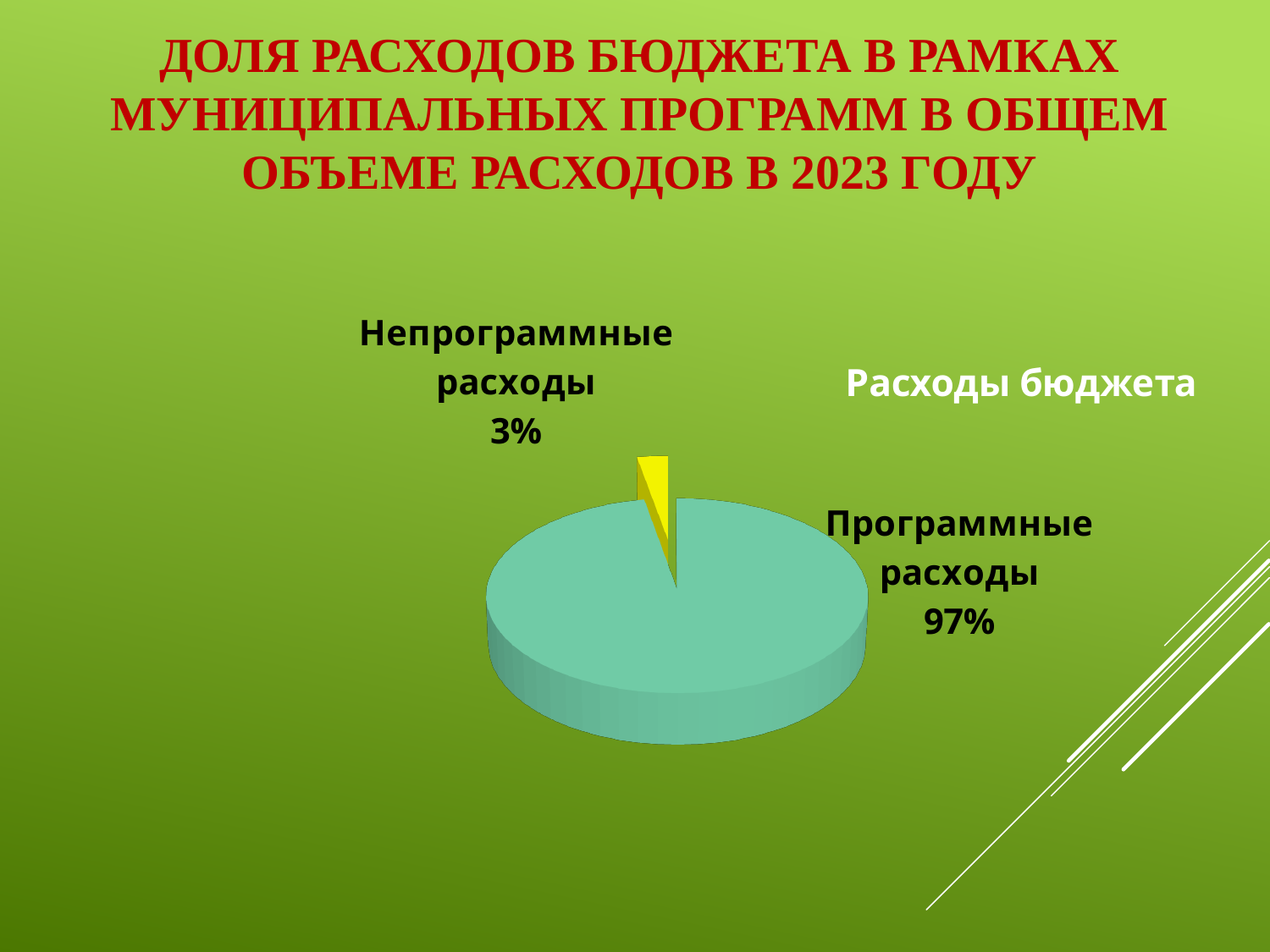
Which slice of the pie is the smallest? Непрограммные расходы What colour is the slice for Непрограммные расходы? Yellow What kind of chart is shown on the slide? Pie chart What share of the pie does Непрограммные расходы have? 3% Which is larger, Программные расходы or Непрограммные расходы? Программные расходы What is the title of the chart? Расходы бюджета What is the difference in percentage points between Программные расходы and Непрограммные расходы? 94 What is the total of the two slices shown in the pie chart? 100% Which slice of the pie is the largest? Программные расходы How many slices does the pie chart have? 2 What share of the pie does Программные расходы have? 97%